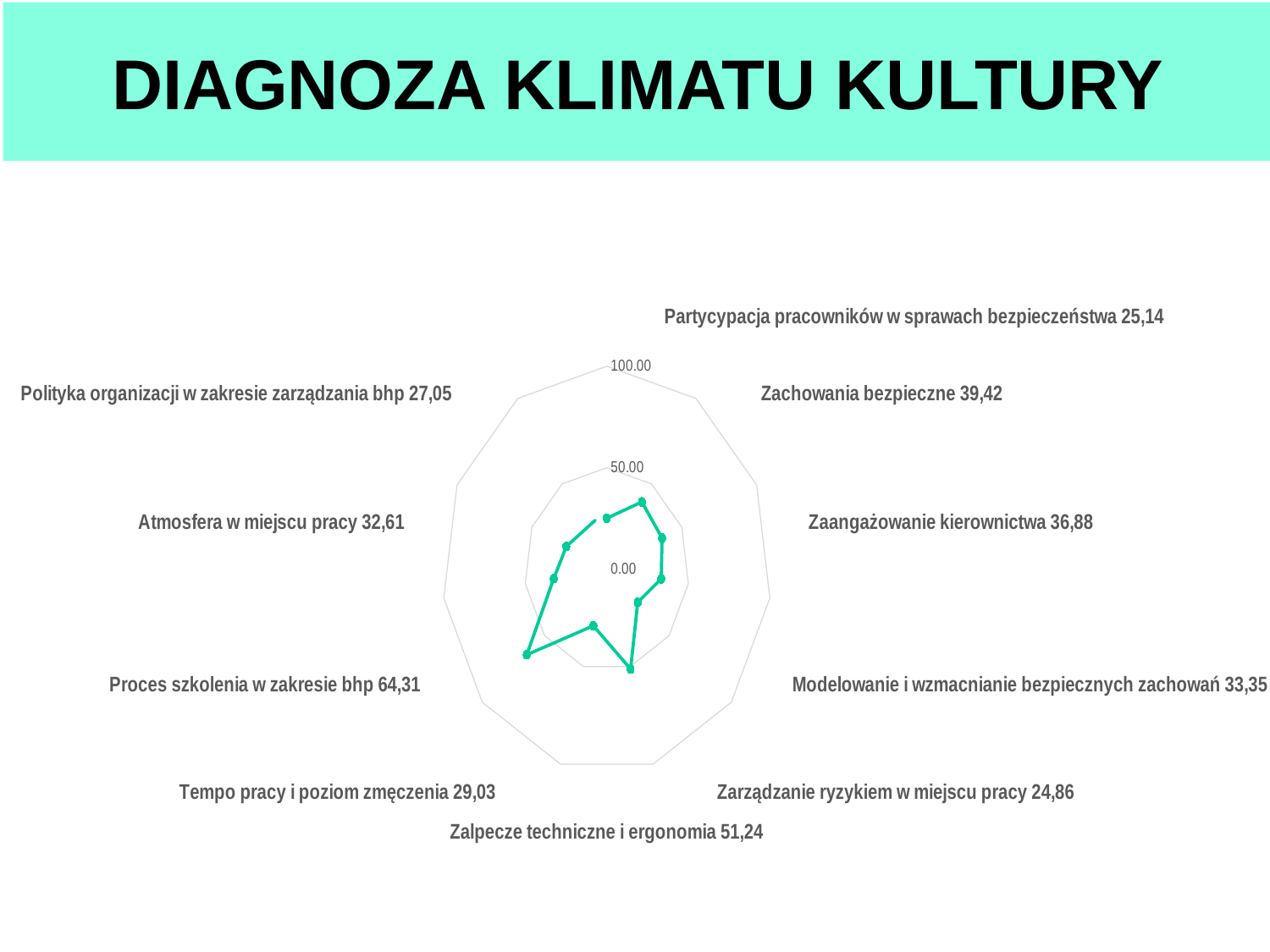
Which category has the lowest value? Zarządzanie ryzykiem w miejscu pracy What is the value for Proces szkolenia w zakresie bhp? 64,31 What is the title of the slide containing the chart? DIAGNOZA KLIMATU KULTURY What is the difference between the values for Proces szkolenia w zakresie bhp and Zalpecze techniczne i ergonomia? 13,07 Which category has the highest value? Proces szkolenia w zakresie bhp Is the value for Tempo pracy i poziom zmęczenia greater or less than 50.00? less What is the value for Zalpecze techniczne i ergonomia? 51,24 What kind of chart is shown on the slide? Radar chart Which is larger, the value for Zaangażowanie kierownictwa or the value for Modelowanie i wzmacnianie bezpiecznych zachowań? Zaangażowanie kierownictwa What is the value for Atmosfera w miejscu pracy? 32,61 What is the value for Zachowania bezpieczne? 39,42 How many categories are plotted on the radar chart? 10